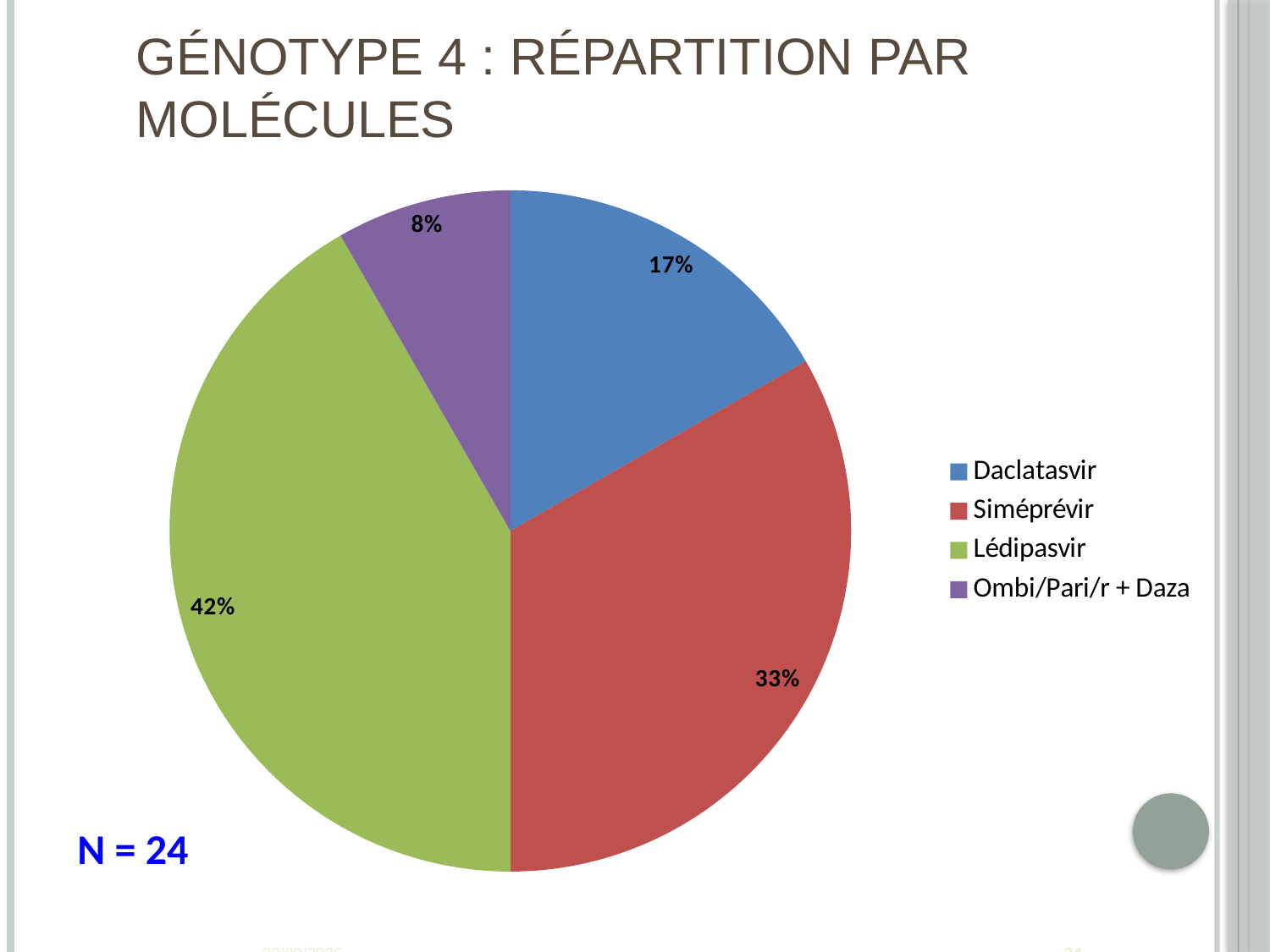
What percentage of the pie does Daclatasvir represent? 17% What type of chart is shown on the slide? pie chart What percentage of the pie does Siméprévir represent? 33% What percentage of the pie does Lédipasvir represent? 42% How many slices does the pie chart have? 4 What colour is the Lédipasvir slice? green Which slice is larger, Daclatasvir or Siméprévir? Siméprévir What is the value of N shown on the slide? 24 What is the difference in percentage points between the Lédipasvir and Siméprévir slices? 9 What percentage of the pie does Ombi/Pari/r + Daza represent? 8% Which molecule has the largest share of the pie? Lédipasvir Which molecule has the smallest share of the pie? Ombi/Pari/r + Daza